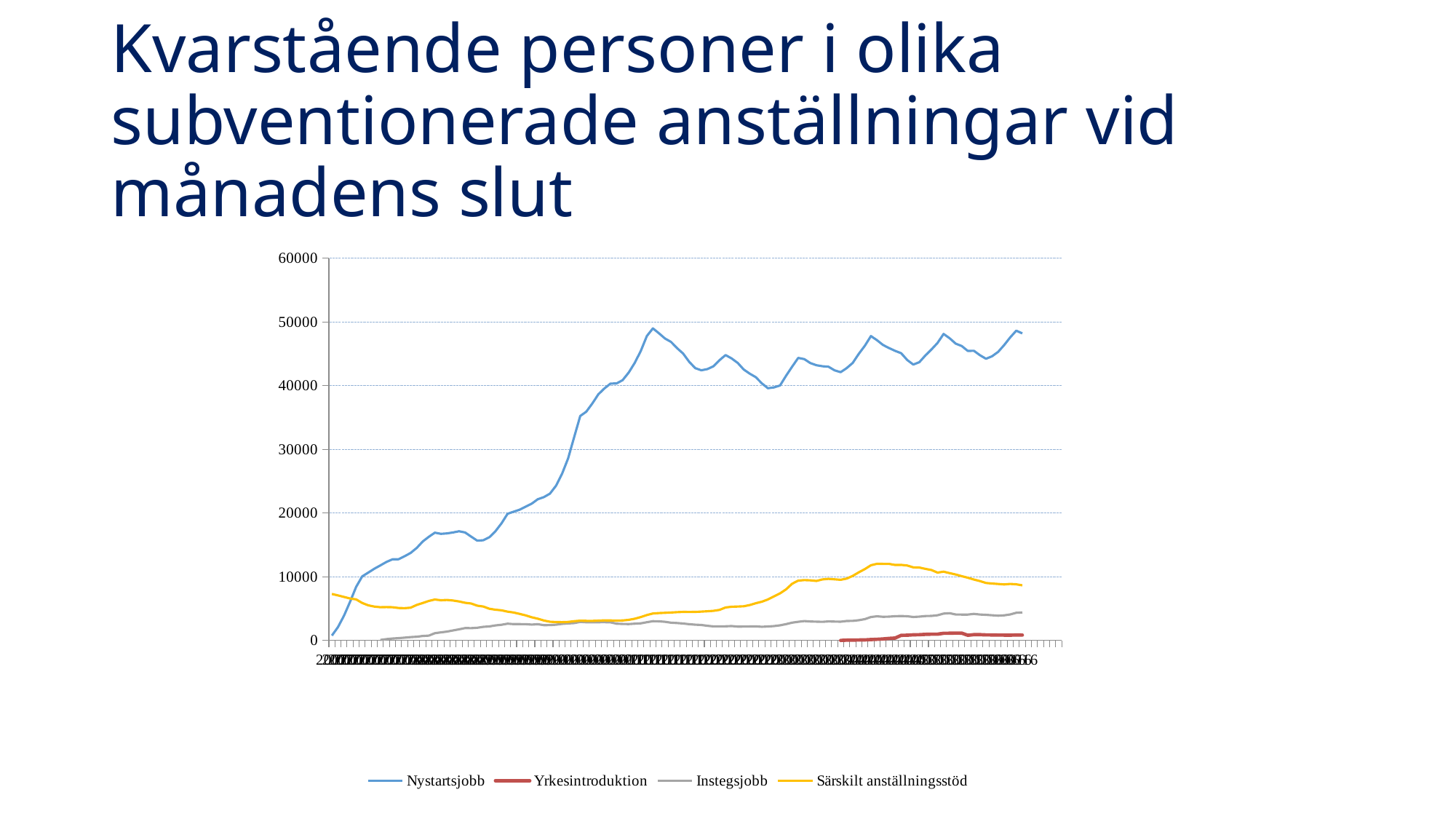
Which series reaches the highest values in the chart? Nystartsjobb Does the Nystartsjobb series overall rise or fall from the left to the right of the chart? rise Is the peak value of the Nystartsjobb series greater or less than 50000? less Is the highest value of the Särskilt anställningsstöd series greater or less than 10000? greater Is the peak value of the Nystartsjobb series greater or less than 40000? greater Which series has the lowest values in the chart? Yrkesintroduktion What colour is the line for Yrkesintroduktion? red At the right end of the chart, which series is higher: Instegsjobb or Särskilt anställningsstöd? Särskilt anställningsstöd What kind of chart is shown on the slide? line chart What is the title of the slide above the chart? Kvarstående personer i olika subventionerade anställningar vid månadens slut How many series does the legend list? 4